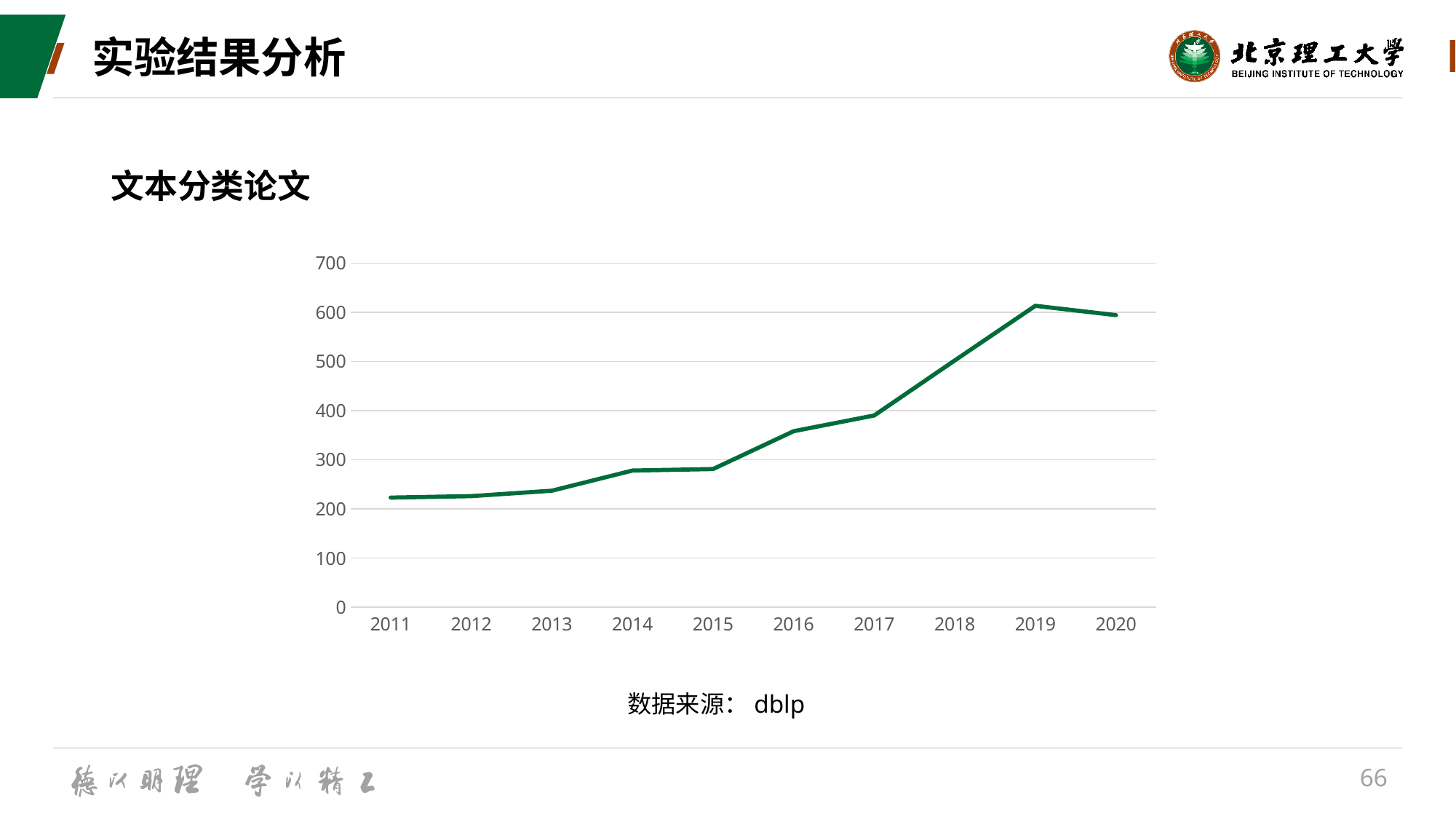
Is the value for 2011 greater or less than 300? less Is the value for 2016 greater or less than 400? less Which is larger, the value for 2020 or the value for 2018? 2020 Which year has the highest value in the chart? 2019 How many years are plotted on the x axis of the chart? 10 Is the value for 2020 greater or less than 500? greater Which is larger, the value for 2016 or the value for 2014? 2016 What data source is cited below the chart? dblp Does the line generally rise or fall from 2011 to 2019? rise What kind of chart is shown on the slide? line chart